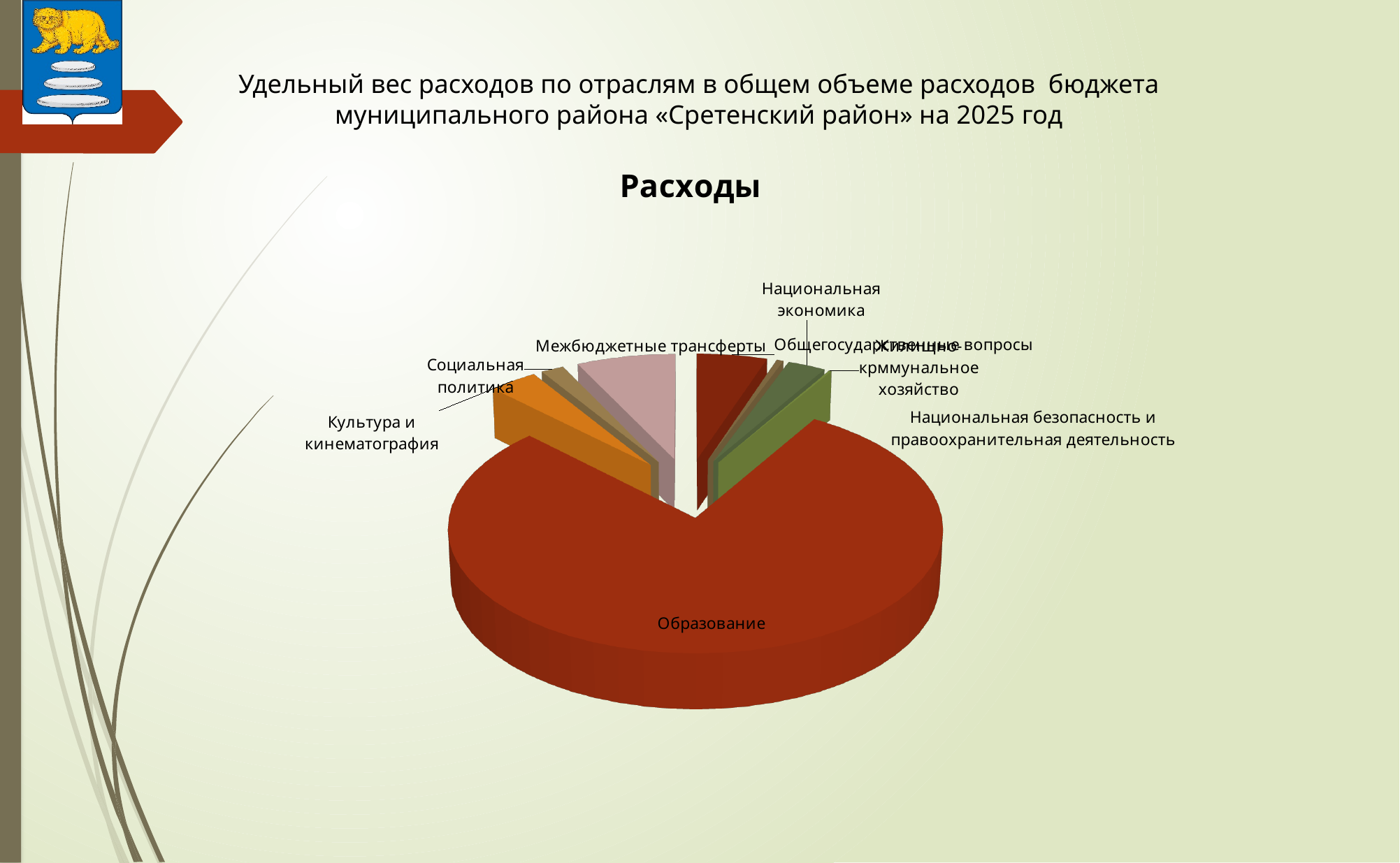
What is the title of the chart? Расходы Which is larger: the slice for Культура и кинематография or the slice for Социальная политика? Культура и кинематография How many categories (slices) does the pie chart have? 8 What colour is the slice for Образование? red What kind of chart is shown on the slide? pie chart Which is larger: the slice for Образование or the slice for Национальная экономика? Образование Which is larger: the slice for Образование or the slice for Межбюджетные трансферты? Образование Which category has the largest share of the pie? Образование